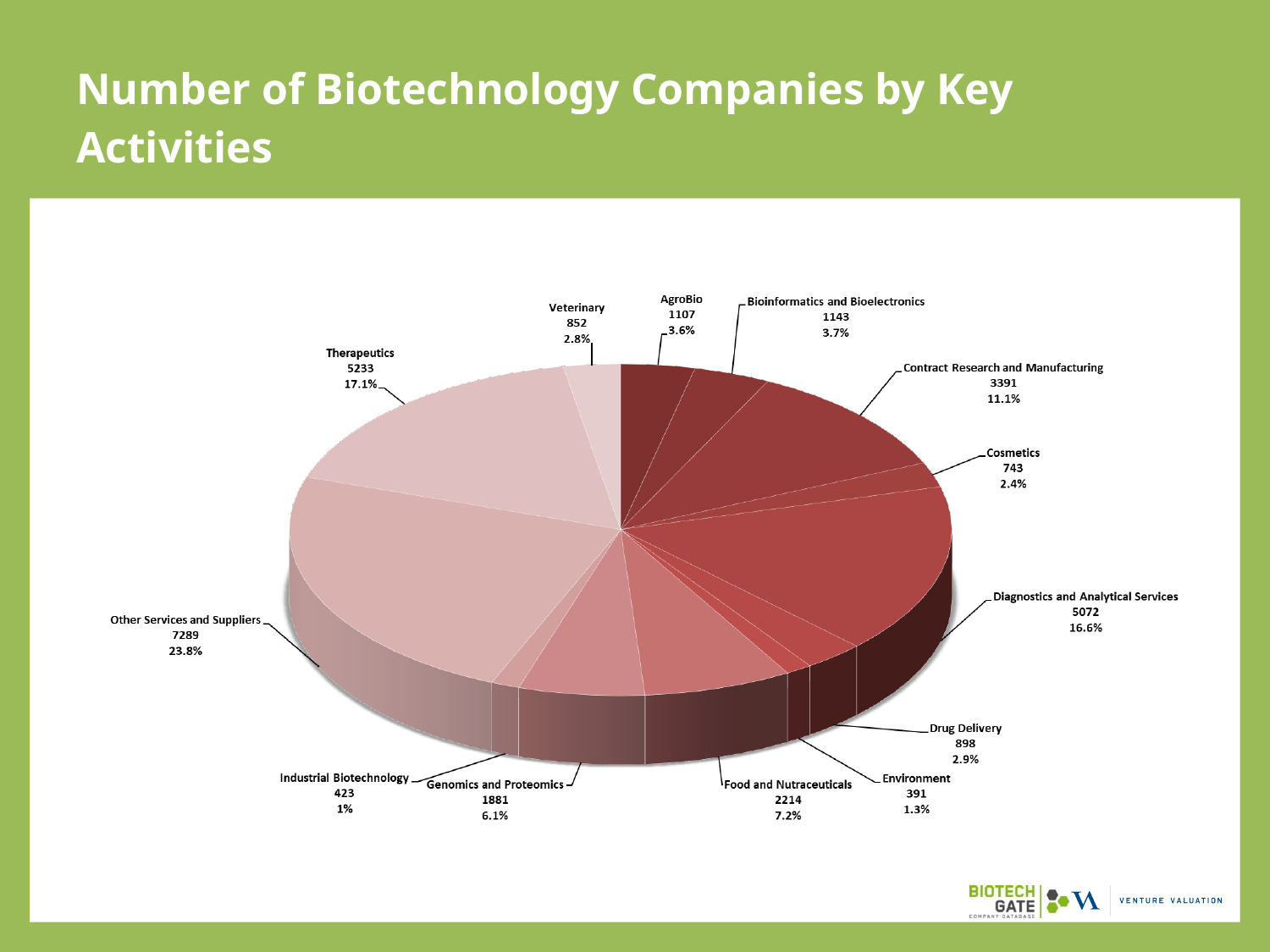
Which has more companies, Contract Research and Manufacturing or Food and Nutraceuticals? Contract Research and Manufacturing How many companies are in the Diagnostics and Analytical Services category? 5072 How many companies are in the Therapeutics category? 5233 Which category has the smallest number of companies? Environment What is the difference in the number of companies between Therapeutics and Diagnostics and Analytical Services? 161 What percentage share does Genomics and Proteomics have? 6.1% How many companies are in the Cosmetics category? 743 What is the title of the chart? Number of Biotechnology Companies by Key Activities What share of the pie does Other Services and Suppliers represent? 23.8% Which category has the largest number of companies? Other Services and Suppliers How many categories are shown in the pie chart? 13 What type of chart is shown on the slide? Pie chart